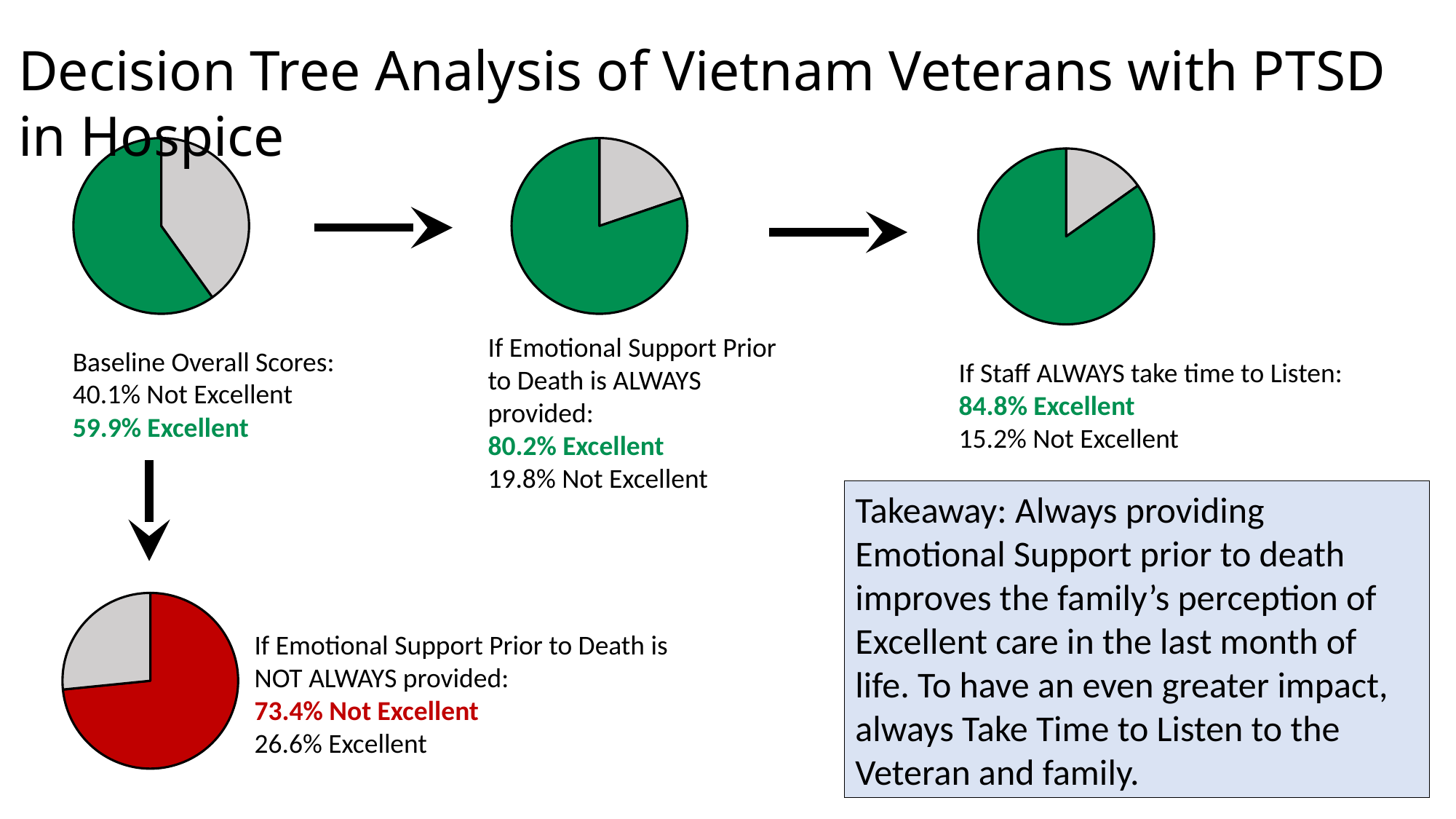
What kind of chart is used to show the Baseline Overall Scores? Pie chart By how many percentage points does the Excellent share when Emotional Support is ALWAYS provided (80.2%) exceed the Baseline Excellent share (59.9%)? 20.3 percentage points In the pie chart for when Emotional Support Prior to Death is NOT ALWAYS provided, what percentage is Not Excellent? 73.4% In the pie chart for when Emotional Support Prior to Death is ALWAYS provided, what percentage is Excellent? 80.2% What colour is the Not Excellent slice in the pie chart for when Emotional Support Prior to Death is NOT ALWAYS provided? Red In the Baseline Overall Scores pie chart, what share of scores is Not Excellent? 40.1% In the pie chart for when Emotional Support Prior to Death is ALWAYS provided, what percentage is Not Excellent? 19.8% In the pie chart for when Staff ALWAYS take time to Listen, what percentage is Excellent? 84.8% In the pie chart for when Emotional Support Prior to Death is NOT ALWAYS provided, what percentage is Excellent? 26.6% Which pie chart has the larger Excellent share: the one for Emotional Support ALWAYS provided or the one for Staff ALWAYS take time to Listen? Staff ALWAYS take time to Listen How many pie charts are shown on the slide? 4 In the Baseline Overall Scores pie chart, what share of scores is Excellent? 59.9%